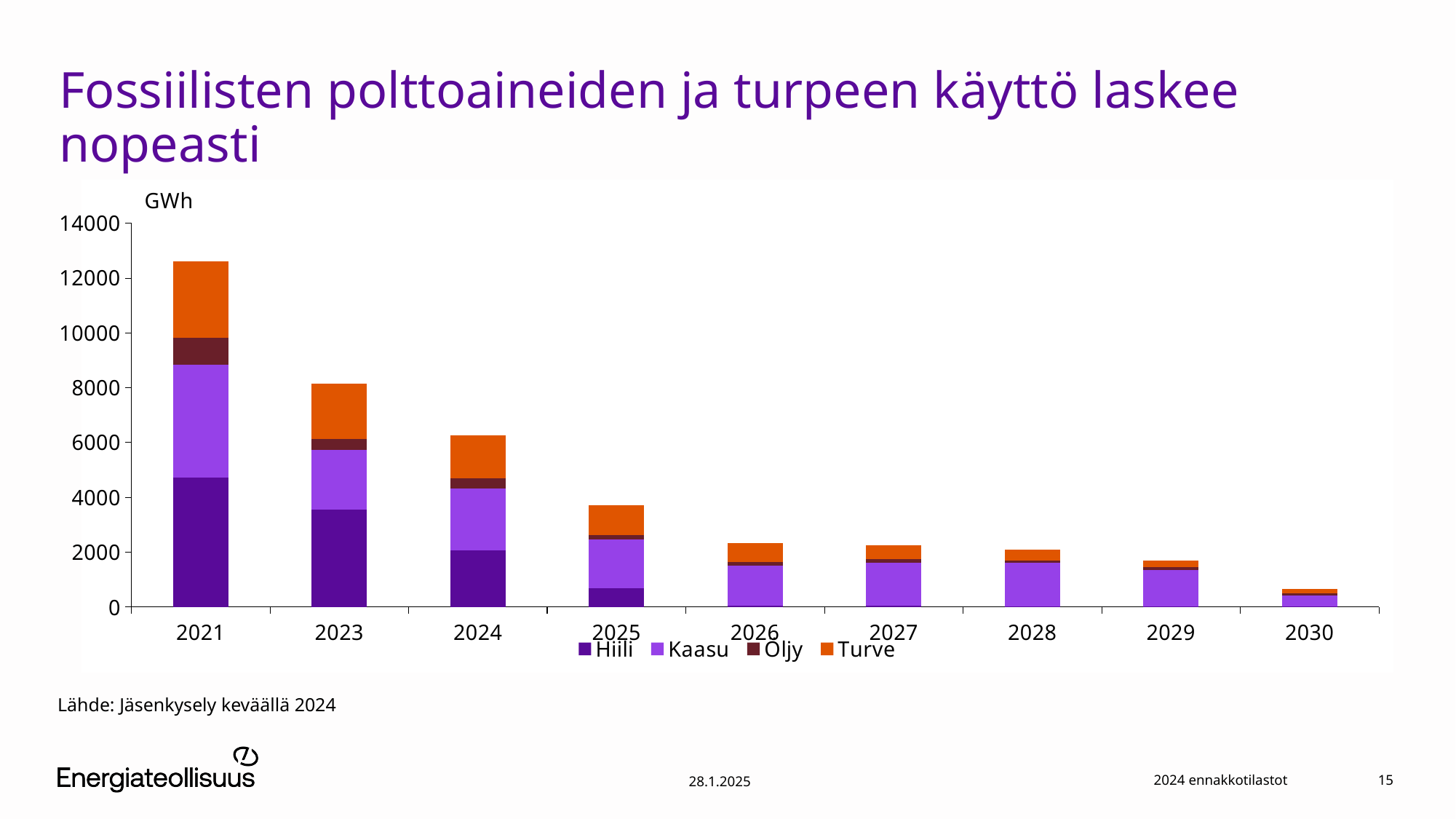
Is the total value for 2030 greater or less than 2000? less Which is larger, the total for 2024 or the total for 2027? 2024 Is the total value for 2021 greater or less than 12000? greater How many years are shown on the x axis? 9 Which year has the highest total stacked bar? 2021 Which year has the lowest total stacked bar? 2030 Is the total value for 2025 greater or less than 4000? less Which series is shown in orange in the legend? Turve How many series does the legend list? 4 Do the total values rise or fall from 2021 to 2030? fall What unit is shown on the y axis? GWh What kind of chart is shown on the slide? bar chart